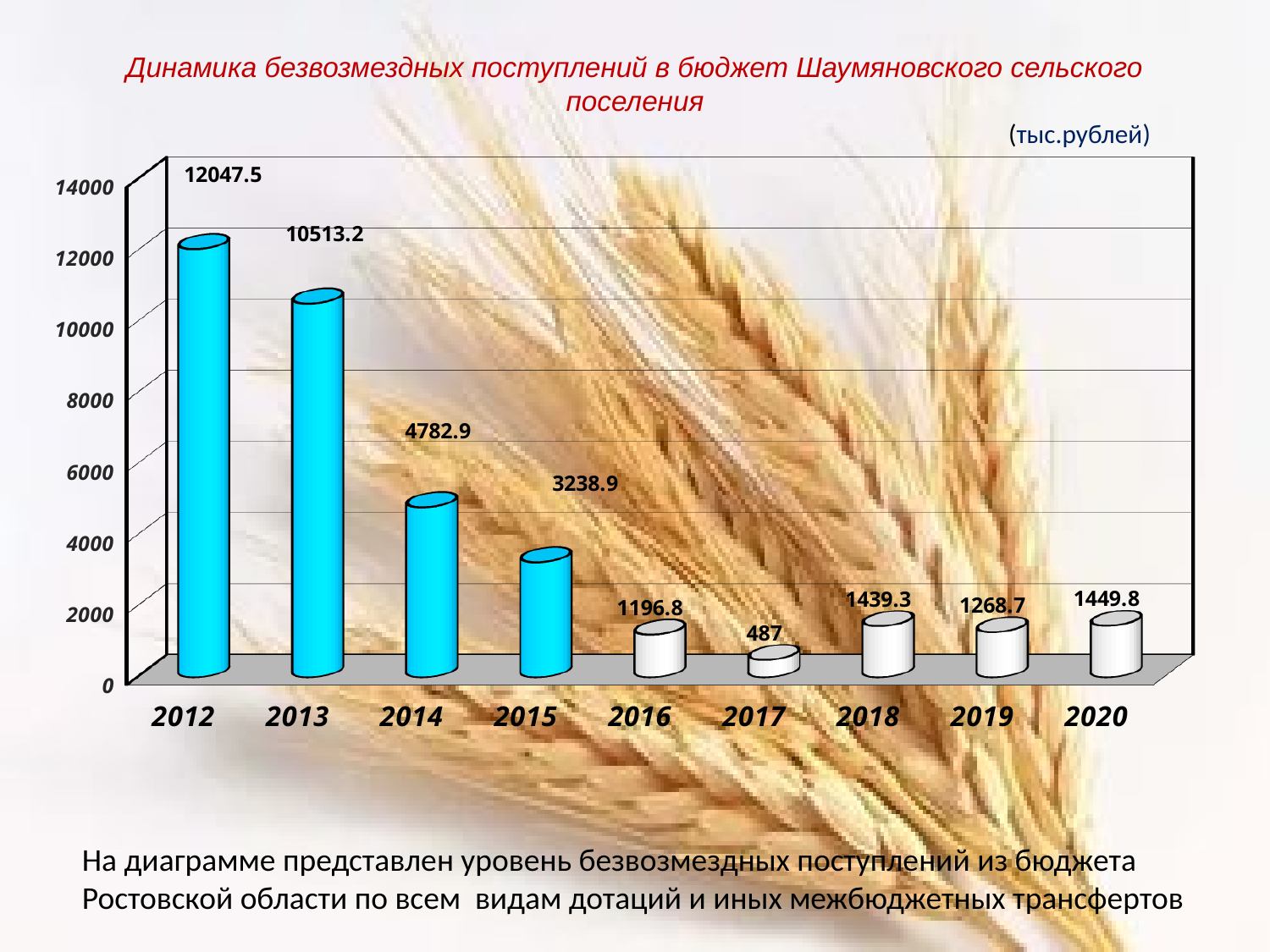
Which year has the highest value? 2012 What is the value for 2012? 12047.5 What is the value for 2020? 1449.8 What is the difference between the values for 2012 and 2013? 1534.3 How many years are shown on the x axis? 9 Which year has the lowest value? 2017 Is the value for 2014 greater or less than 4000? greater What is the value for 2017? 487 Which is larger, the value for 2014 or the value for 2015? 2014 What kind of chart is shown on the slide? bar chart Do the values rise or fall from 2012 to 2017? fall What is the difference between the values for 2018 and 2017? 952.3